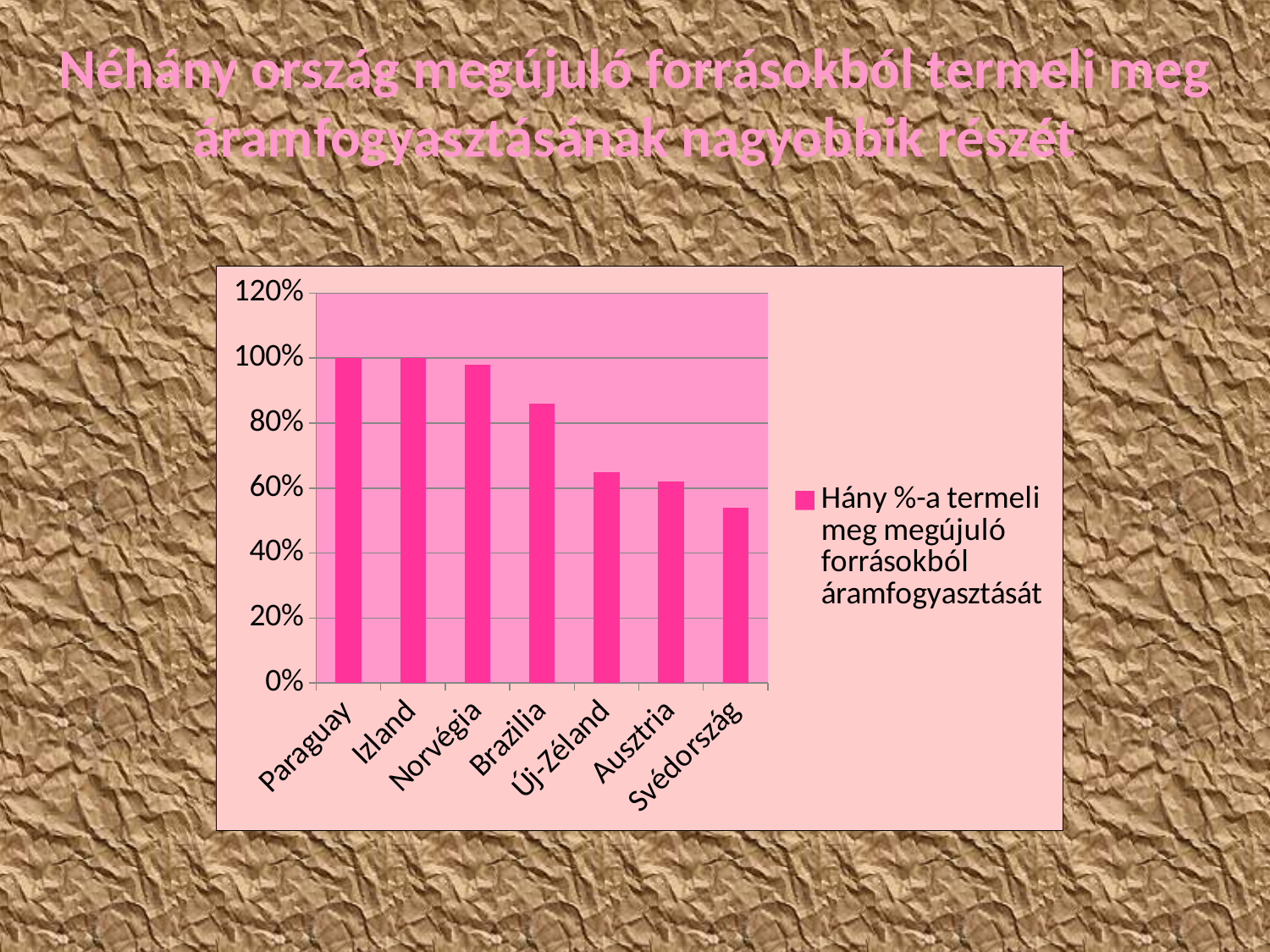
What is the legend entry of the series in the chart? Hány %-a termeli meg megújuló forrásokból áramfogyasztását Is the value for Svédország greater or less than 60%? less What kind of chart is shown on the slide? bar chart Is the value for Norvégia greater or less than 80%? greater Which has a larger value, Ausztria or Svédország? Ausztria Is the value for Új-Zéland greater or less than 60%? greater How many series does the chart's legend list? 1 Do the values rise or fall from left to right along the x axis? fall Which country has the lowest value in the chart? Svédország How many countries are shown on the x axis of the chart? 7 Which has a larger value, Brazília or Új-Zéland? Brazília